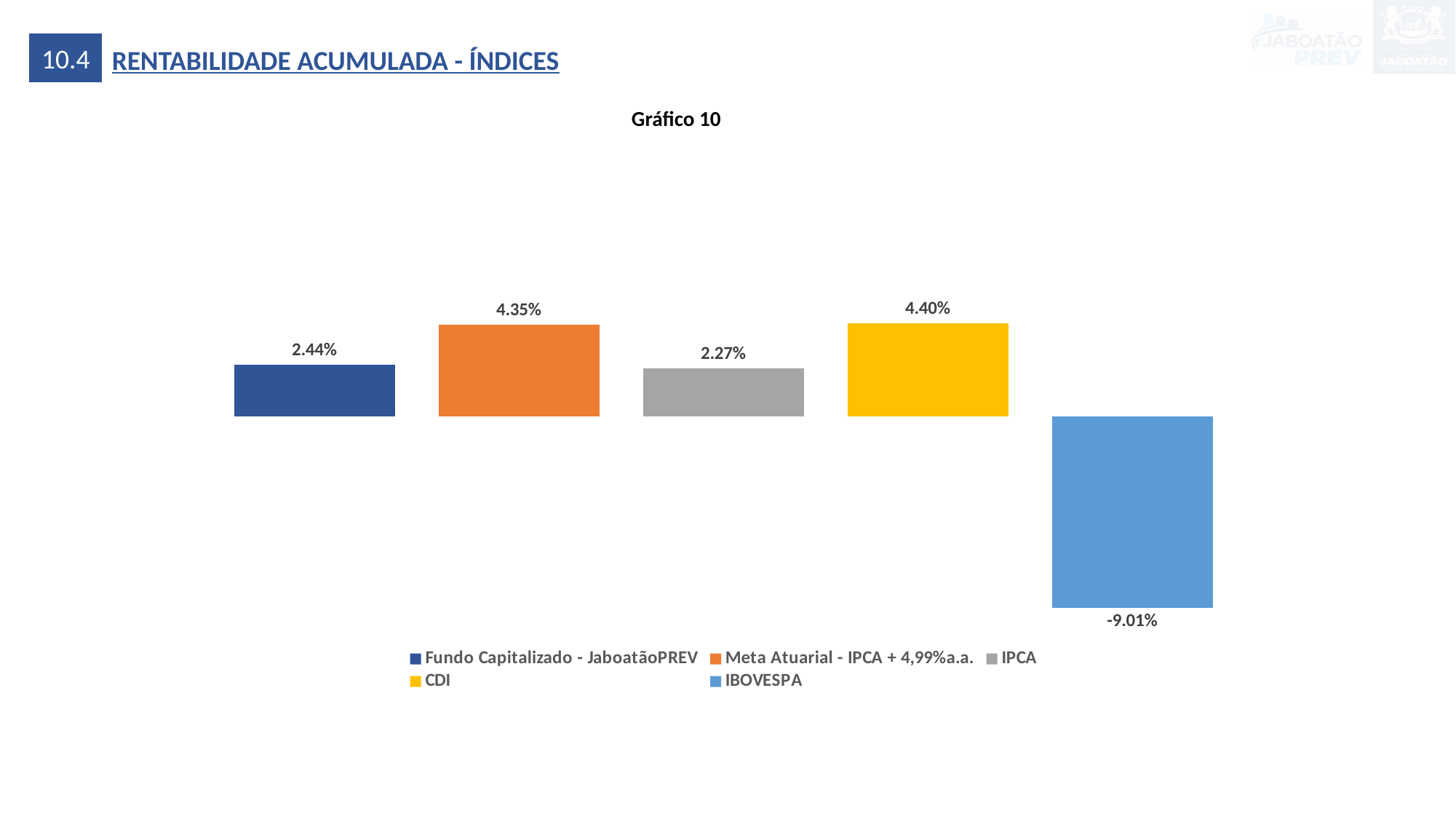
How many bars are plotted in the chart? 5 What is the difference between the Meta Atuarial - IPCA + 4,99%a.a. value and the Fundo Capitalizado - JaboatãoPREV value? 1.91% Which series has the highest value in the chart? CDI What kind of chart is shown on the slide? Bar chart What is the value shown for IBOVESPA? -9.01% What is the value shown for IPCA? 2.27% What is the value shown for CDI? 4.40% What is the value shown for Fundo Capitalizado - JaboatãoPREV? 2.44% What is the difference between the CDI value and the Meta Atuarial - IPCA + 4,99%a.a. value? 0.05% How many series does the legend list? 5 Which is larger, the value for Fundo Capitalizado - JaboatãoPREV or the value for IPCA? Fundo Capitalizado - JaboatãoPREV Which series has the lowest value in the chart? IBOVESPA